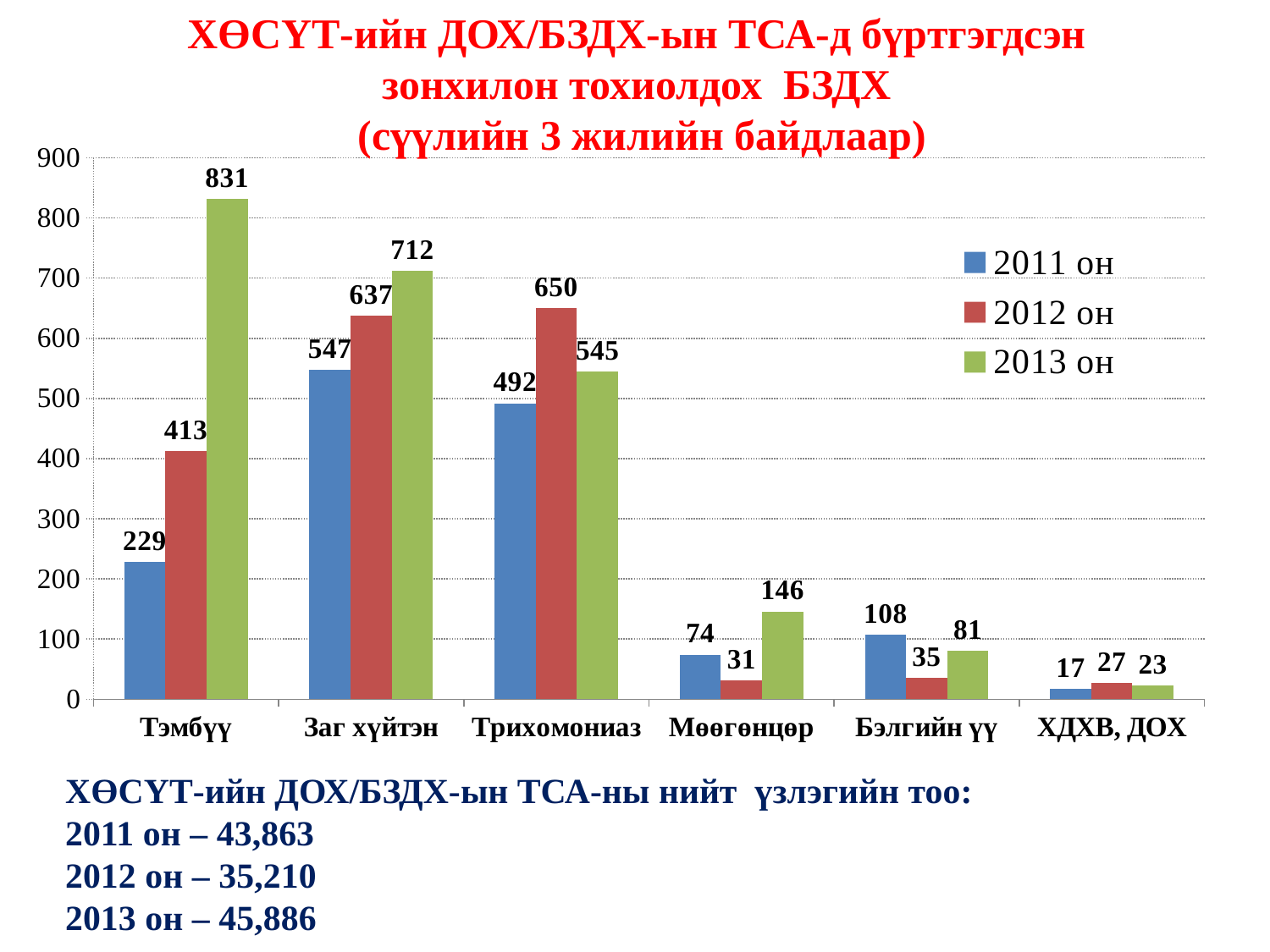
How many categories are shown on the x axis? 6 How many series does the legend list? 3 Do the values for Тэмбүү rise or fall from 2011 он to 2013 он? rise Which category has the highest value in the 2013 он series? Тэмбүү Is the value for Трихомониаз in 2011 он greater or less than 500? less What is the value for Мөөгөнцөр in 2011 он? 74 What is the value for Тэмбүү in 2013 он? 831 Which is larger for Заг хүйтэн: the 2012 он value or the 2013 он value? 2013 он What is the difference between the 2013 он and 2011 он values for Тэмбүү? 602 What is the value for Трихомониаз in 2012 он? 650 What kind of chart is shown on the slide? bar chart Which category has the lowest value in the 2011 он series? ХДХВ, ДОХ